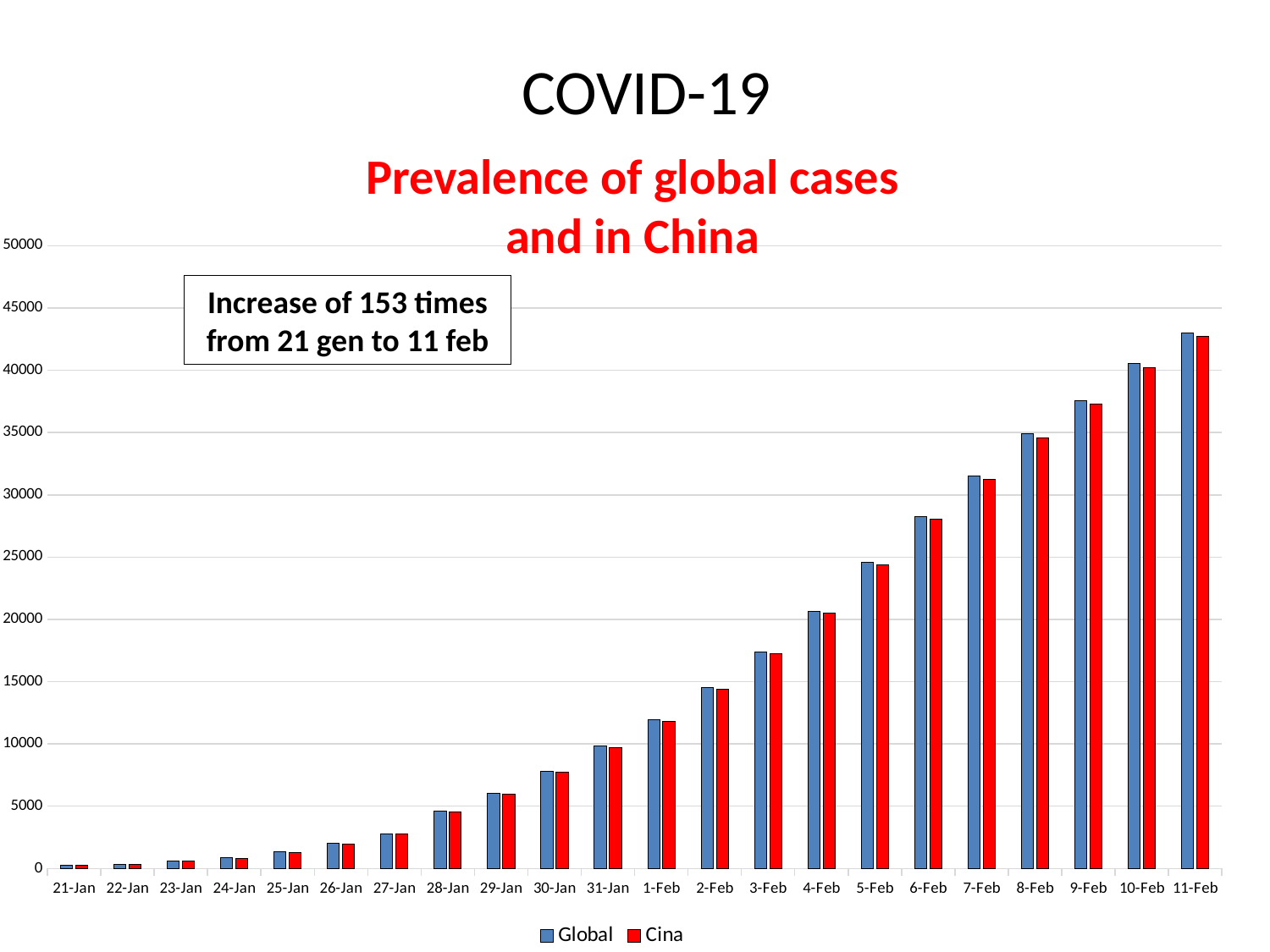
How many dates are shown on the x axis? 22 Is the Global value for 11-Feb greater or less than 40000? greater Is the Global value for 30-Jan greater or less than 10000? less On which date is the Global value highest? 11-Feb What colour are the Cina bars? red Is the Global value for 3-Feb greater or less than 15000? greater Do the values rise or fall from 21-Jan to 11-Feb? rise Which is larger, the Global value for 10-Feb or the Global value for 11-Feb? 11-Feb On which date is the Cina value lowest? 21-Jan How many series does the legend list? 2 What kind of chart is shown on the slide? bar chart